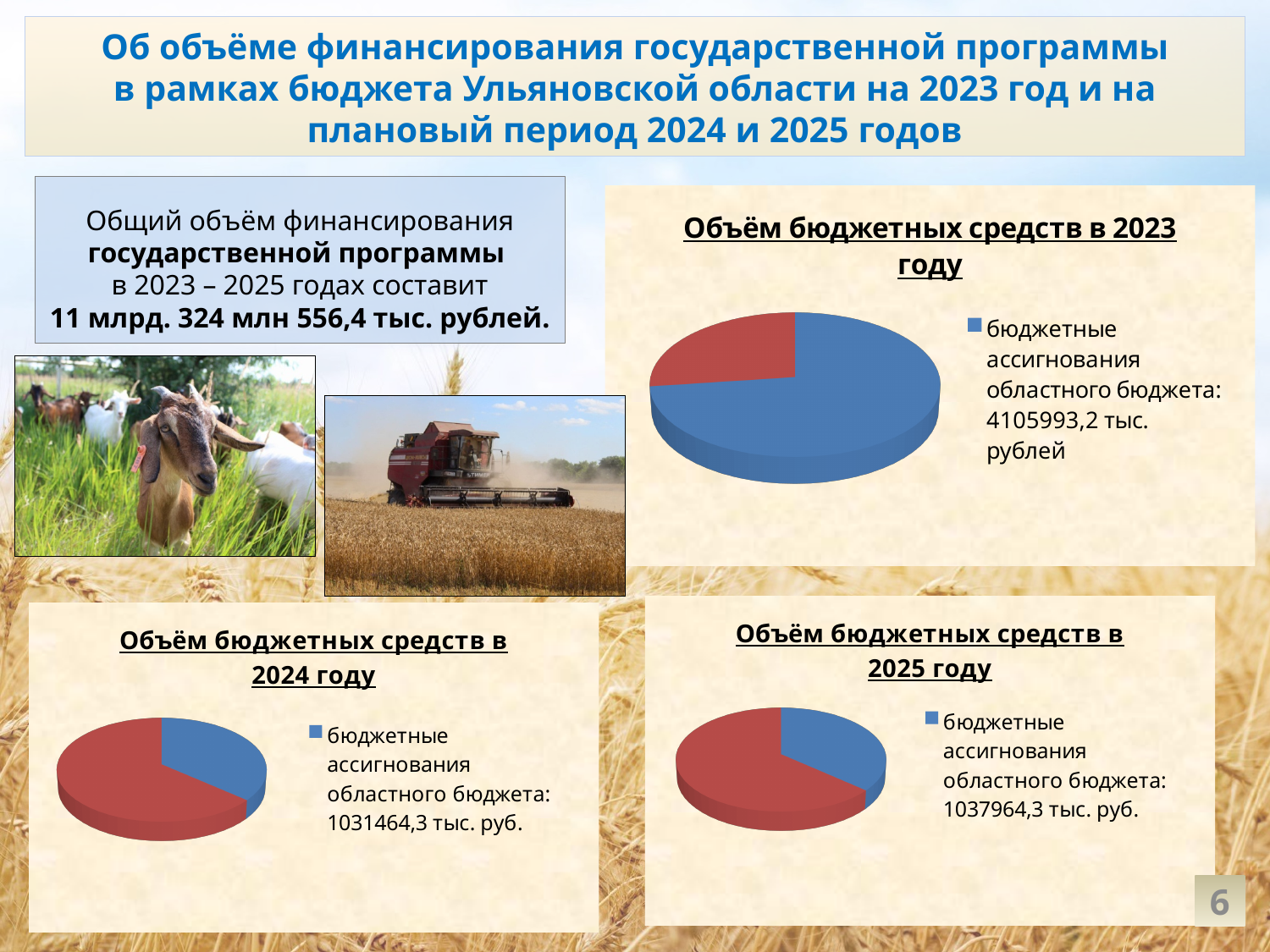
What colour is the slice labelled in the legend of the chart "Объём бюджетных средств в 2025 году"? blue How many pie charts are shown on the slide? 3 In the chart "Объём бюджетных средств в 2024 году", which slice is larger, the blue one or the red one? the red one What kind of chart is "Объём бюджетных средств в 2024 году"? pie chart In the chart "Объём бюджетных средств в 2025 году", which slice is larger, the blue one or the red one? the red one In the chart "Объём бюджетных средств в 2023 году", what value does the legend give for бюджетные ассигнования областного бюджета? 4105993,2 тыс. рублей What kind of chart is "Объём бюджетных средств в 2023 году"? pie chart How many entries does the legend of the chart "Объём бюджетных средств в 2023 году" list? 1 How many slices does the pie chart "Объём бюджетных средств в 2023 году" have? 2 In the chart "Объём бюджетных средств в 2025 году", what value does the legend give for бюджетные ассигнования областного бюджета? 1037964,3 тыс. руб. In the chart "Объём бюджетных средств в 2024 году", what value does the legend give for бюджетные ассигнования областного бюджета? 1031464,3 тыс. руб. In the chart "Объём бюджетных средств в 2023 году", which slice is larger, the blue one or the red one? the blue one